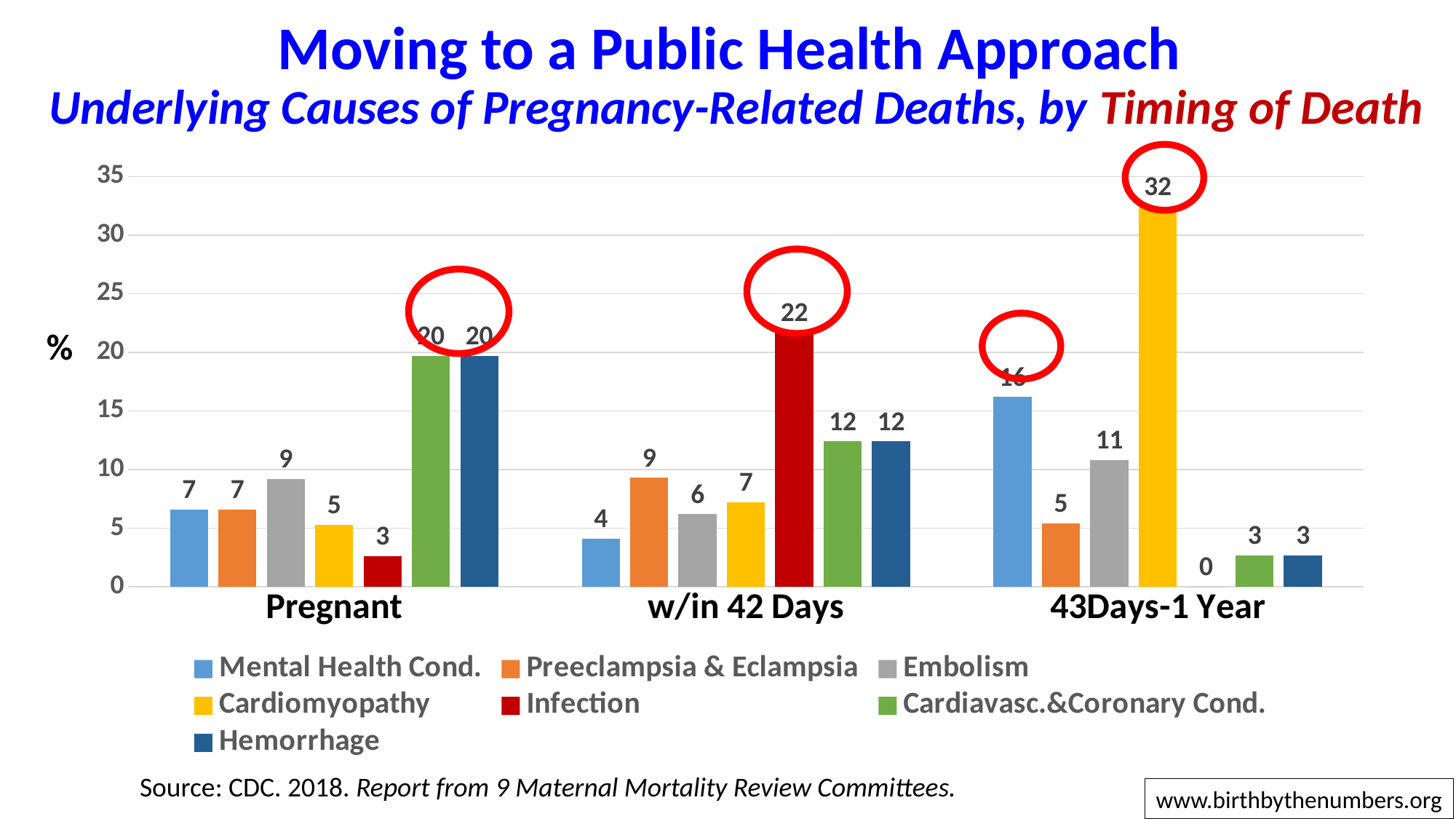
What is the label on the vertical axis? % Which series has the lowest value in the 43Days-1 Year category? Infection Which series has the highest value in the w/in 42 Days category? Infection How many series does the legend list? 7 What is the value for Cardiomyopathy in the 43Days-1 Year category? 32 What is the value for Hemorrhage in the Pregnant category? 20 What is the value for Mental Health Cond. in the 43Days-1 Year category? 16 How many categories are shown on the x axis? 3 What is the difference between the Cardiomyopathy value in 43Days-1 Year and the Cardiomyopathy value in Pregnant? 27 What is the value for Infection in the w/in 42 Days category? 22 What kind of chart is shown on the slide? Bar chart Which is larger: Embolism in Pregnant or Embolism in w/in 42 Days? Embolism in Pregnant